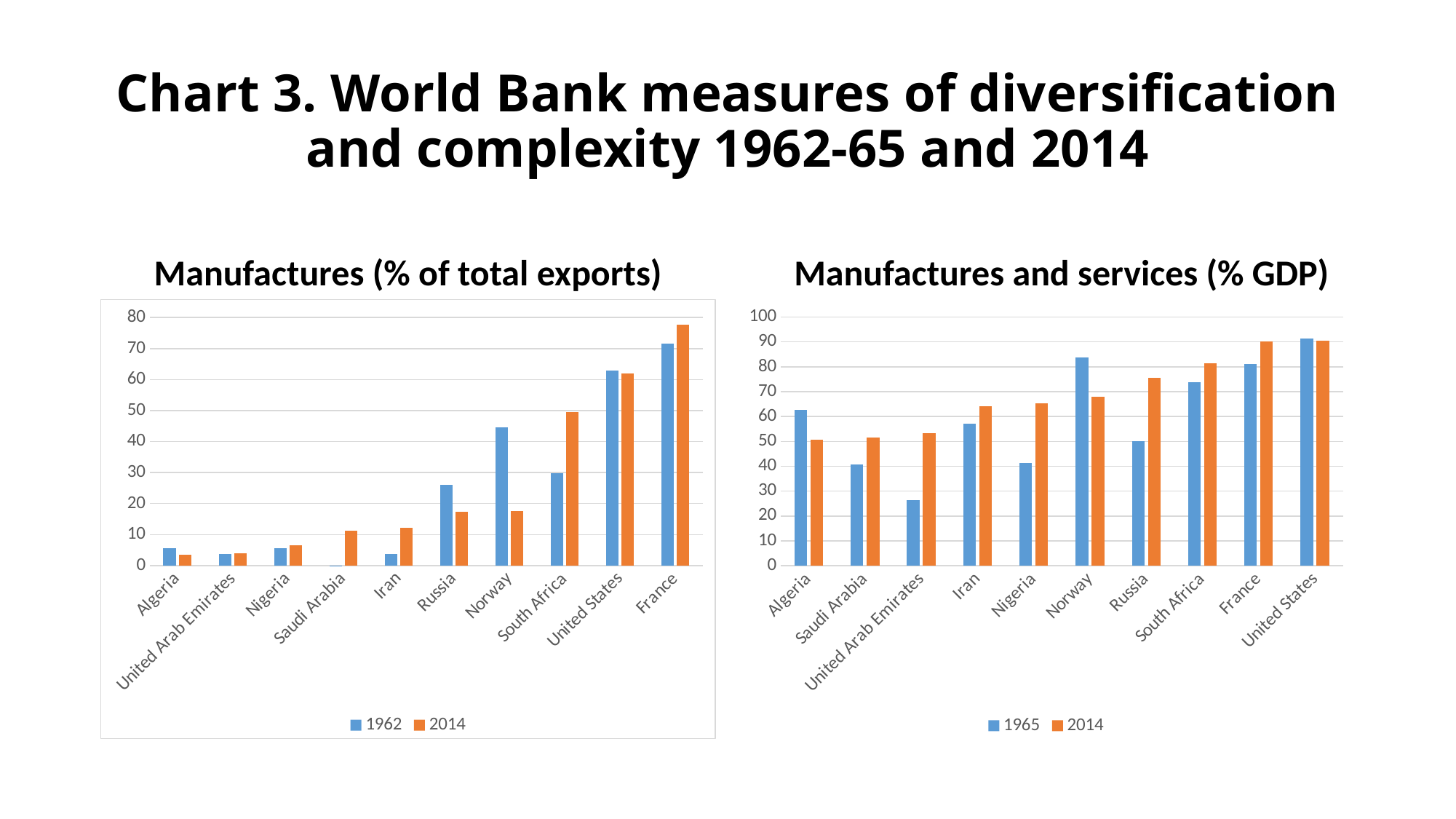
On the 'Manufactures and services (% GDP)' chart, which is larger for Norway: the 1965 value or the 2014 value? 1965 How many countries are shown on the 'Manufactures (% of total exports)' chart? 10 On the 'Manufactures (% of total exports)' chart, is the 2014 value for Russia greater or less than 20? less On the 'Manufactures and services (% GDP)' chart, which country has the highest 1965 value? United States What kind of chart is the 'Manufactures (% of total exports)' chart? bar chart How many series does the legend of the 'Manufactures (% of total exports)' chart list? 2 On the 'Manufactures and services (% GDP)' chart, which country has the lowest 1965 value? United Arab Emirates What are the two series listed in the legend of the 'Manufactures and services (% GDP)' chart? 1965 and 2014 On the 'Manufactures (% of total exports)' chart, is the 1962 value for Norway greater or less than 40? greater On the 'Manufactures (% of total exports)' chart, which is larger for Norway: the 1962 value or the 2014 value? 1962 On the 'Manufactures and services (% GDP)' chart, is the 1965 value for Norway greater or less than 80? greater On the 'Manufactures (% of total exports)' chart, which country has the highest 2014 value? France